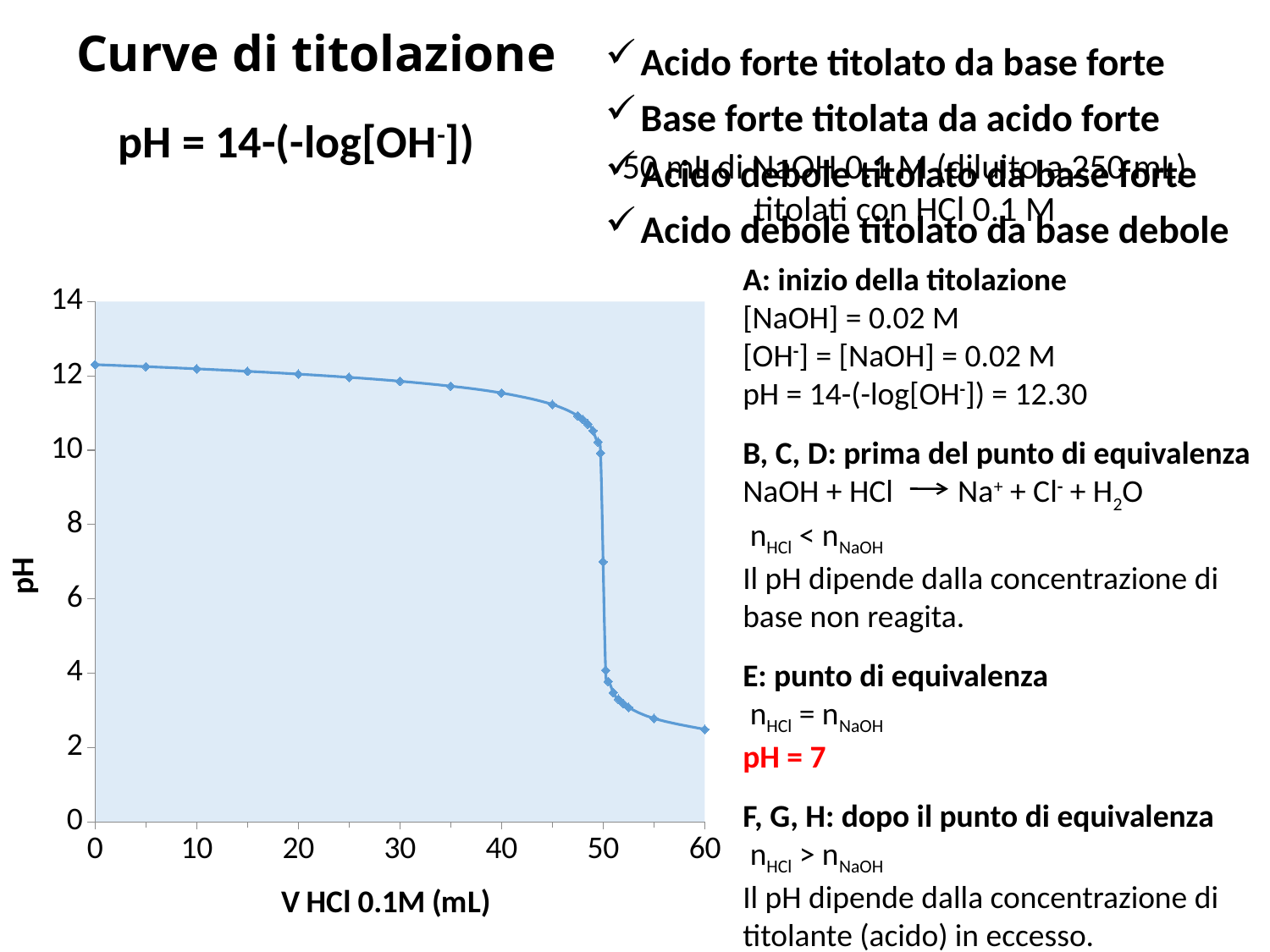
What kind of chart is shown on the slide? line chart At which volume of HCl on the x axis is the pH lowest? 60 Is the pH at 55 mL of HCl greater or less than 4? less At which volume of HCl on the x axis is the pH highest? 0 What is the label of the x axis of the chart? V HCl 0.1M (mL) Is the pH at 30 mL of HCl greater or less than 10? greater Does the pH rise or fall as the volume of HCl increases along the x axis? fall Is the pH at 20 mL of HCl greater or less than 8? greater What is the label of the y axis of the chart? pH Which has the higher pH: 10 mL of HCl or 55 mL of HCl? 10 mL